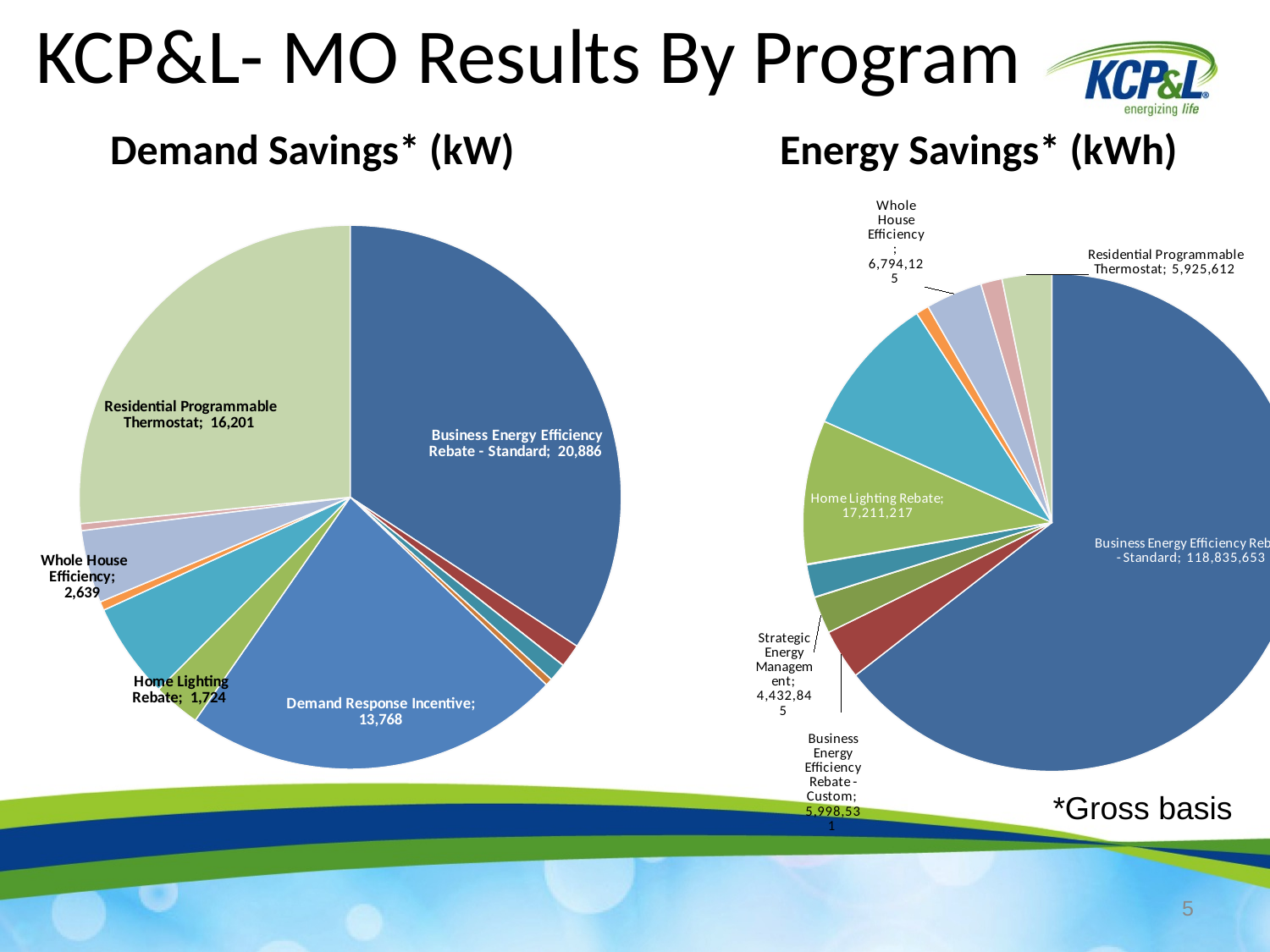
What kind of chart is the Demand Savings* (kW) chart? Pie chart In the Demand Savings* (kW) chart, what is the value for Demand Response Incentive? 13,768 In the Demand Savings* (kW) chart, how much larger is Business Energy Efficiency Rebate - Standard than Residential Programmable Thermostat? 4,685 In the Demand Savings* (kW) chart, what is the value for Residential Programmable Thermostat? 16,201 In the Energy Savings* (kWh) chart, what is the value for Whole House Efficiency? 6,794,125 In the Demand Savings* (kW) chart, which program has the largest slice? Business Energy Efficiency Rebate - Standard In the Energy Savings* (kWh) chart, which is larger: Whole House Efficiency or Residential Programmable Thermostat? Whole House Efficiency In the Energy Savings* (kWh) chart, what is the difference between Business Energy Efficiency Rebate - Custom and Strategic Energy Management? 1,565,686 In the Demand Savings* (kW) chart, what is the value for Business Energy Efficiency Rebate - Standard? 20,886 In the Energy Savings* (kWh) chart, which program has the largest slice? Business Energy Efficiency Rebate - Standard In the Energy Savings* (kWh) chart, what is the value for Home Lighting Rebate? 17,211,217 In the Demand Savings* (kW) chart, which is larger: Whole House Efficiency or Home Lighting Rebate? Whole House Efficiency